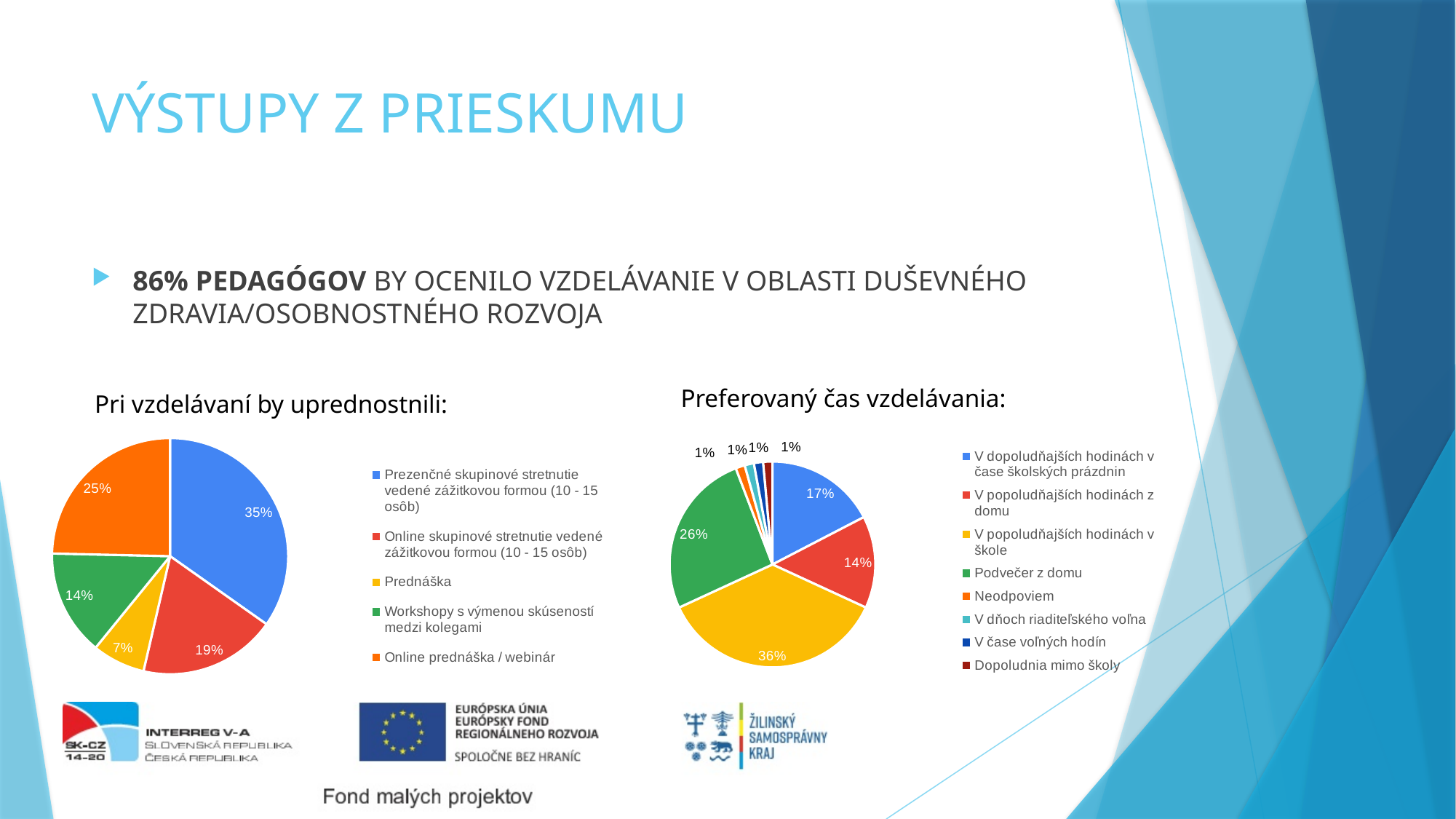
In the pie chart titled "Preferovaný čas vzdelávania:", which category has the largest share? V popoludňajších hodinách v škole In the pie chart titled "Pri vzdelávaní by uprednostnili:", what is the difference in percentage points between "Online prednáška / webinár" and "Online skupinové stretnutie vedené zážitkovou formou (10 - 15 osôb)"? 6 percentage points In the pie chart titled "Preferovaný čas vzdelávania:", which is larger: "V dopoludňajších hodinách v čase školských prázdnin" or "V popoludňajších hodinách z domu"? V dopoludňajších hodinách v čase školských prázdnin In the pie chart titled "Pri vzdelávaní by uprednostnili:", what share is shown for "Prednáška"? 7% In the pie chart titled "Preferovaný čas vzdelávania:", what share is shown for "V popoludňajších hodinách v škole"? 36% In the pie chart titled "Pri vzdelávaní by uprednostnili:", which category has the largest share? Prezenčné skupinové stretnutie vedené zážitkovou formou (10 - 15 osôb) What type of chart is used for "Preferovaný čas vzdelávania:"? Pie chart In the pie chart titled "Preferovaný čas vzdelávania:", what share is shown for "Podvečer z domu"? 26% In the pie chart titled "Pri vzdelávaní by uprednostnili:", what share is shown for "Workshopy s výmenou skúseností medzi kolegami"? 14% In the pie chart titled "Preferovaný čas vzdelávania:", how many categories does the legend list? 8 In the pie chart titled "Pri vzdelávaní by uprednostnili:", how many categories does the legend list? 5 In the pie chart titled "Pri vzdelávaní by uprednostnili:", which category has the smallest share? Prednáška